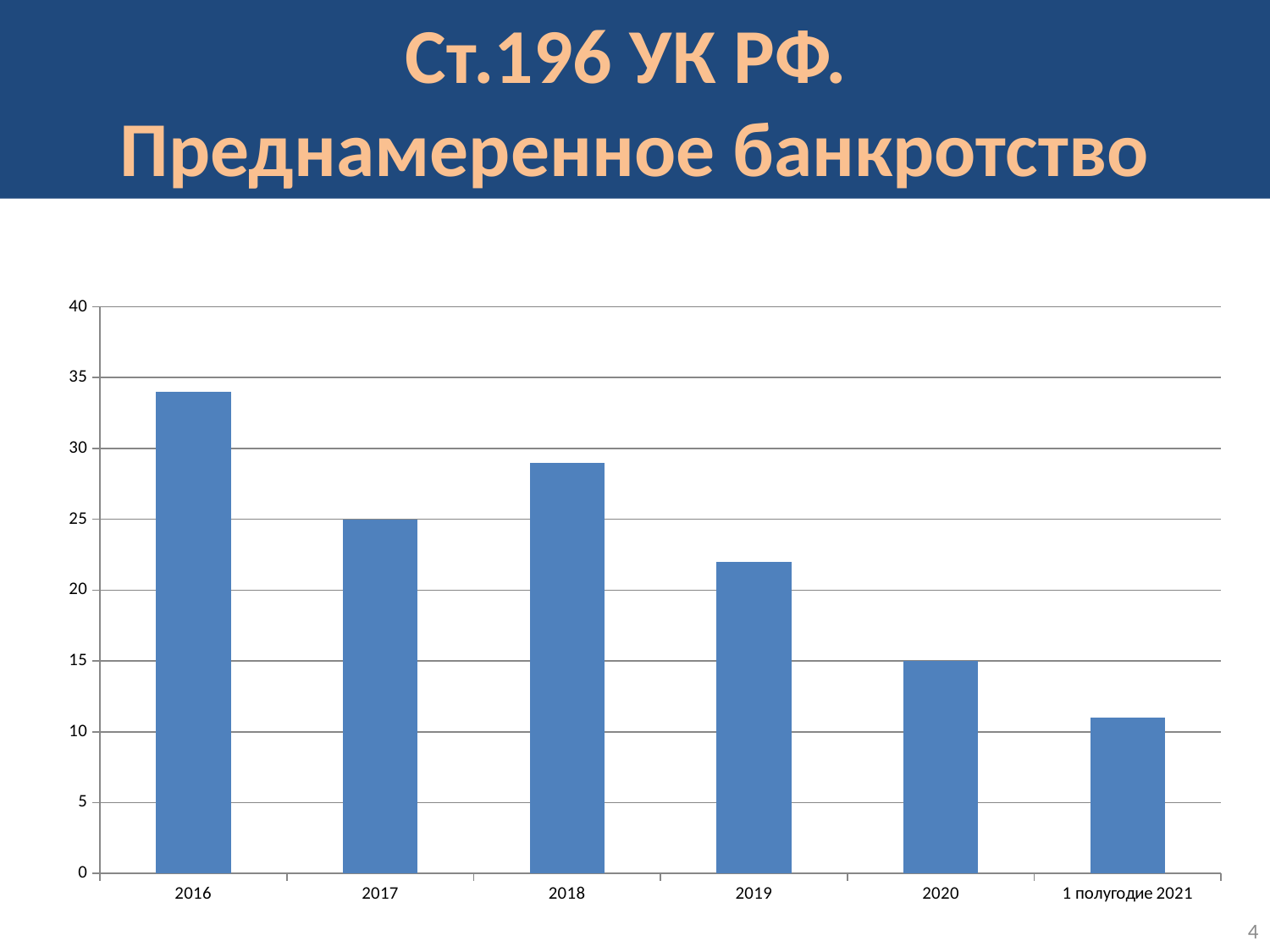
Which is larger, the value for 2018 or the value for 2019? 2018 What type of chart is shown on the slide? bar chart Which category has the highest value? 2016 Is the value for 1 полугодие 2021 greater or less than 15? less Is the value for 2018 greater or less than 30? less How many categories are shown on the x axis of the chart? 6 Is the value for 2019 greater or less than 20? greater What is the value for 2020? 15 What is the value for 2017? 25 What is the difference between the values for 2017 and 2020? 10 Which category has the lowest value? 1 полугодие 2021